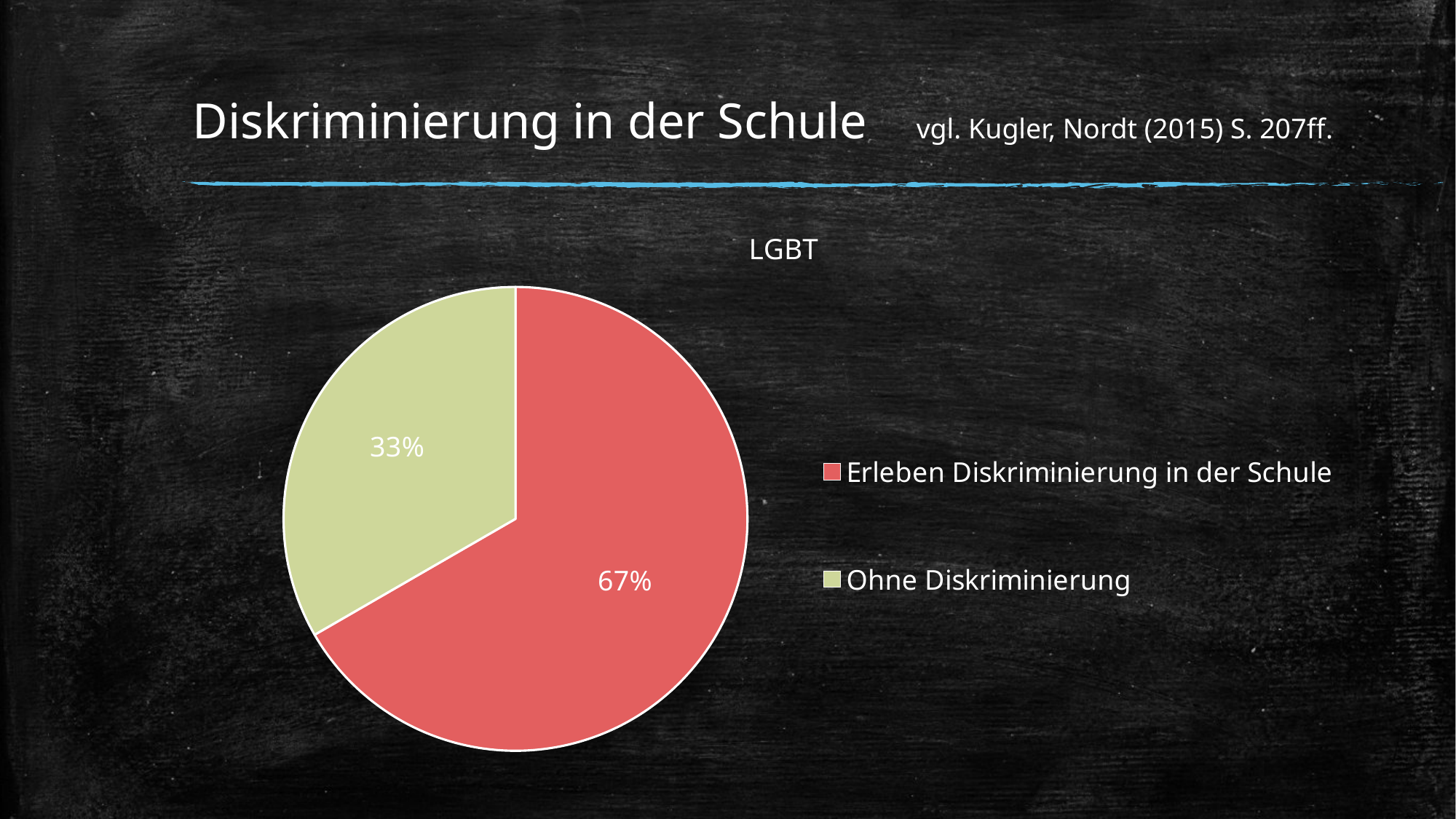
What colour is the "Ohne Diskriminierung" slice? green What kind of chart is shown on the slide? pie chart How many entries does the legend list? 2 Which is larger: the "Erleben Diskriminierung in der Schule" slice or the "Ohne Diskriminierung" slice? Erleben Diskriminierung in der Schule How many slices does the pie chart have? 2 What is the title of the chart? LGBT What percentage of the pie is labelled "Ohne Diskriminierung"? 33% What is the difference in percentage points between the "Erleben Diskriminierung in der Schule" slice and the "Ohne Diskriminierung" slice? 34 What share of the pie does the "Erleben Diskriminierung in der Schule" slice represent? 67% Which slice of the pie is the smallest? Ohne Diskriminierung Which slice of the pie is the largest? Erleben Diskriminierung in der Schule What percentage of the pie is labelled "Erleben Diskriminierung in der Schule"? 67%